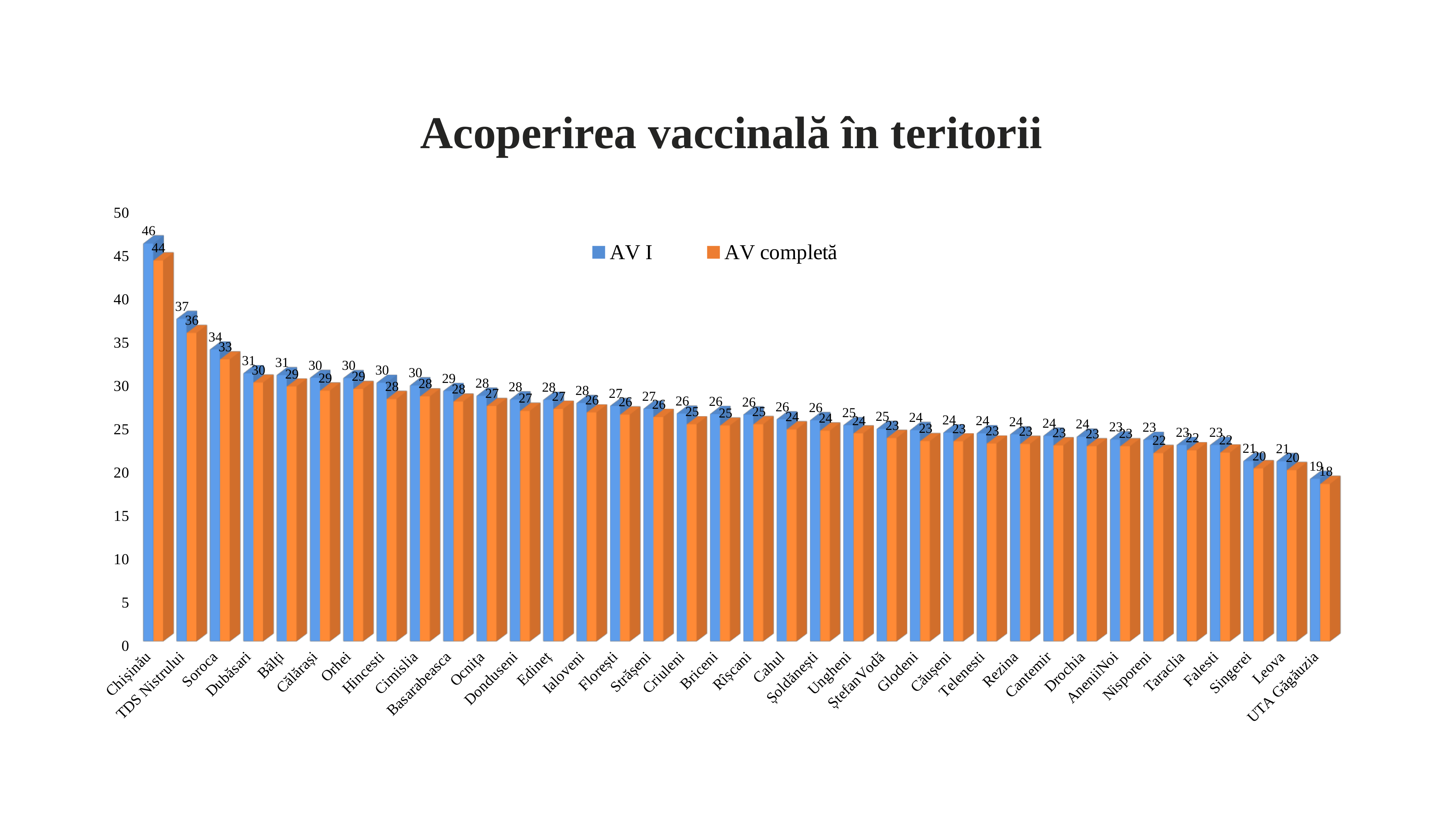
Do the AV I values rise or fall from left to right along the x axis? fall What is the AV completă value for Soroca? 33 What is the AV I value for Chișinău? 46 Which territory has the highest AV I value? Chișinău Which territory has the lowest AV completă value? UTA Găgăuzia What is the title of the chart? Acoperirea vaccinală în teritorii How many territories are shown on the x axis? 36 How many series does the legend list? 2 Which is larger: the AV I value for TDS Nistrului or the AV I value for Soroca? TDS Nistrului What is the difference between the AV I and AV completă values for Chișinău? 2 What is the AV completă value for UTA Găgăuzia? 18 What kind of chart is shown on the slide? bar chart